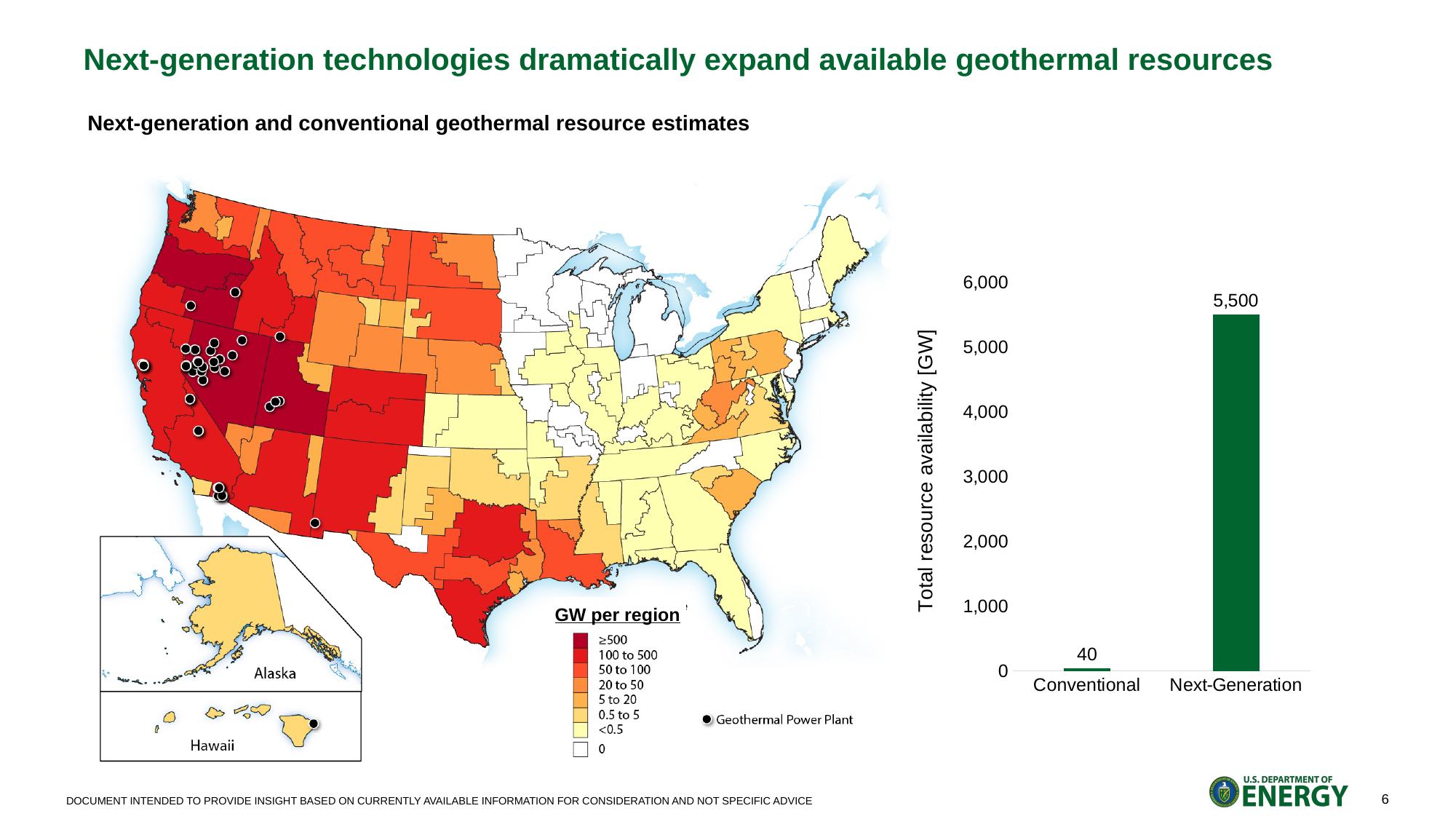
What kind of chart is shown on the right side of the slide? Bar chart What is the y-axis label of the bar chart on the right? Total resource availability [GW] In the bar chart on the right, is the value for Conventional or Next-Generation larger? Next-Generation In the bar chart on the right, is the value for Next-Generation greater or less than 5,000? greater What is the highest tick value shown on the y-axis of the bar chart on the right? 6,000 In the bar chart on the right, what is the total resource availability for Conventional? 40 How many categories are shown in the bar chart on the right? 2 In the bar chart on the right, which category has the highest total resource availability? Next-Generation In the bar chart on the right, what is the difference between the Next-Generation and Conventional values? 5,460 In the bar chart on the right, is the value for Conventional greater or less than 1,000? less In the bar chart on the right, which category has the lowest total resource availability? Conventional In the bar chart on the right, what is the total resource availability for Next-Generation? 5,500